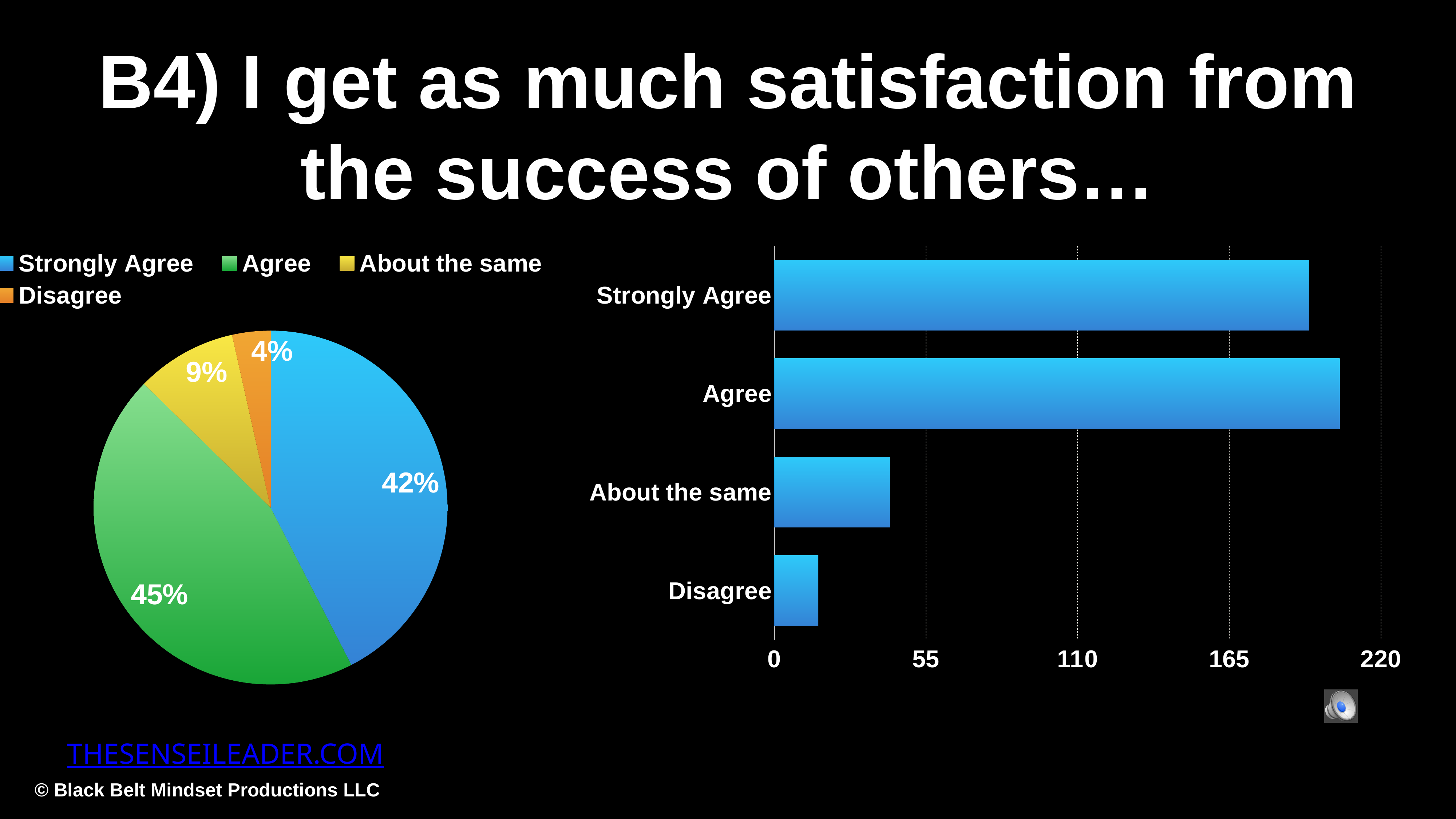
In the pie chart on the left, which is larger: About the same or Disagree? About the same In the pie chart on the left, what is the difference between the Agree and Strongly Agree shares? 3% How many categories are shown in the bar chart on the right? 4 In the bar chart on the right, is the value for About the same greater or less than 55? less In the bar chart on the right, is the value for Strongly Agree greater or less than 165? greater In the pie chart on the left, which category has the smallest share? Disagree In the pie chart on the left, what percentage is shown for Agree? 45% In the pie chart on the left, what percentage is shown for Strongly Agree? 42% In the bar chart on the right, which category has the lowest value? Disagree In the pie chart on the left, what percentage is shown for Disagree? 4% What kind of chart is on the right side of the slide? Bar chart In the pie chart on the left, which category has the largest share? Agree